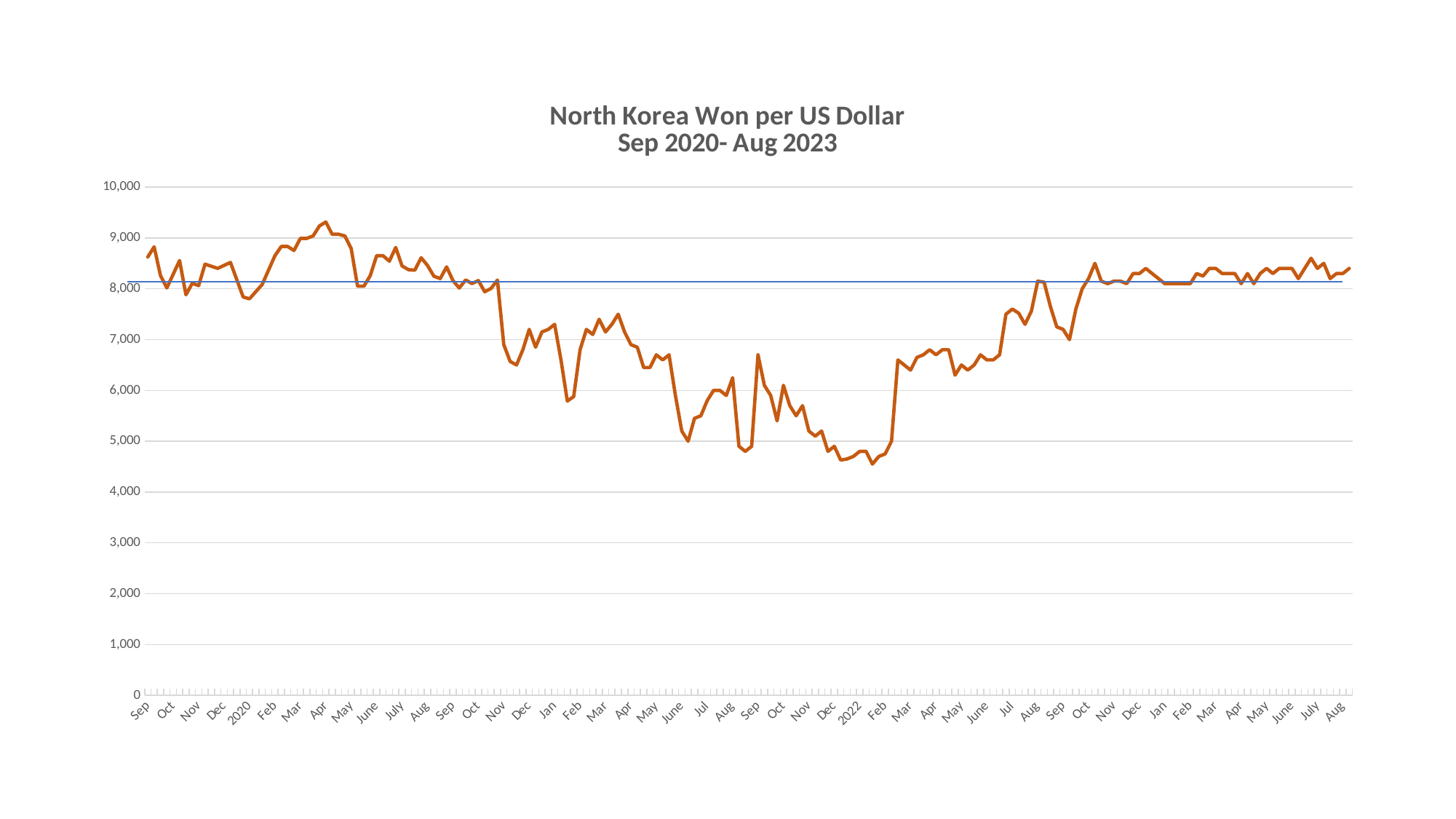
What is the title of the chart? North Korea Won per US Dollar Sep 2020- Aug 2023 Does the line generally rise or fall between the first Apr label and the 2022 label? fall Is the value at the 2022 label greater or less than 5,000? less Is the value at the last Aug label greater or less than 8,000? greater What is the highest value shown on the vertical axis? 10,000 Does the line generally rise or fall between the 2022 label and the last Aug label? rise Is the value at the third Jul label greater or less than 7,000? greater Which is larger, the value at the first Sep label or the value at the 2022 label? the first Sep label What kind of chart is shown on the slide? line chart